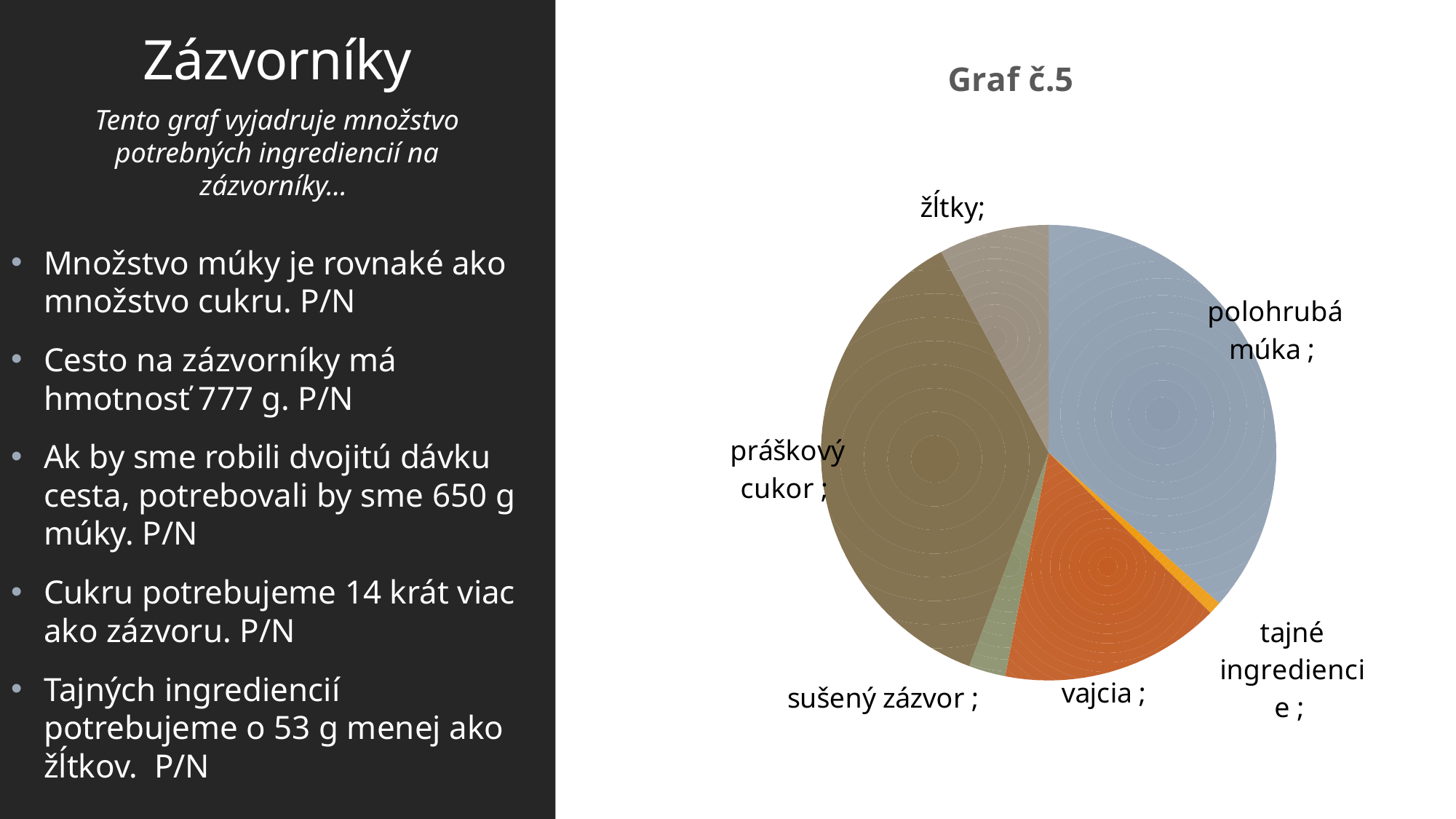
Which slice of the pie chart is the smallest? tajné ingrediencie What is the title of the chart? Graf č.5 Which slice is larger, sušený zázvor or tajné ingrediencie? sušený zázvor How many slices does the pie chart have? 6 Which slice is larger, práškový cukor or vajcia? práškový cukor Which slice is larger, žĺtky or vajcia? vajcia What kind of chart is shown on the slide? pie chart What colour is the polohrubá múka slice? blue-grey